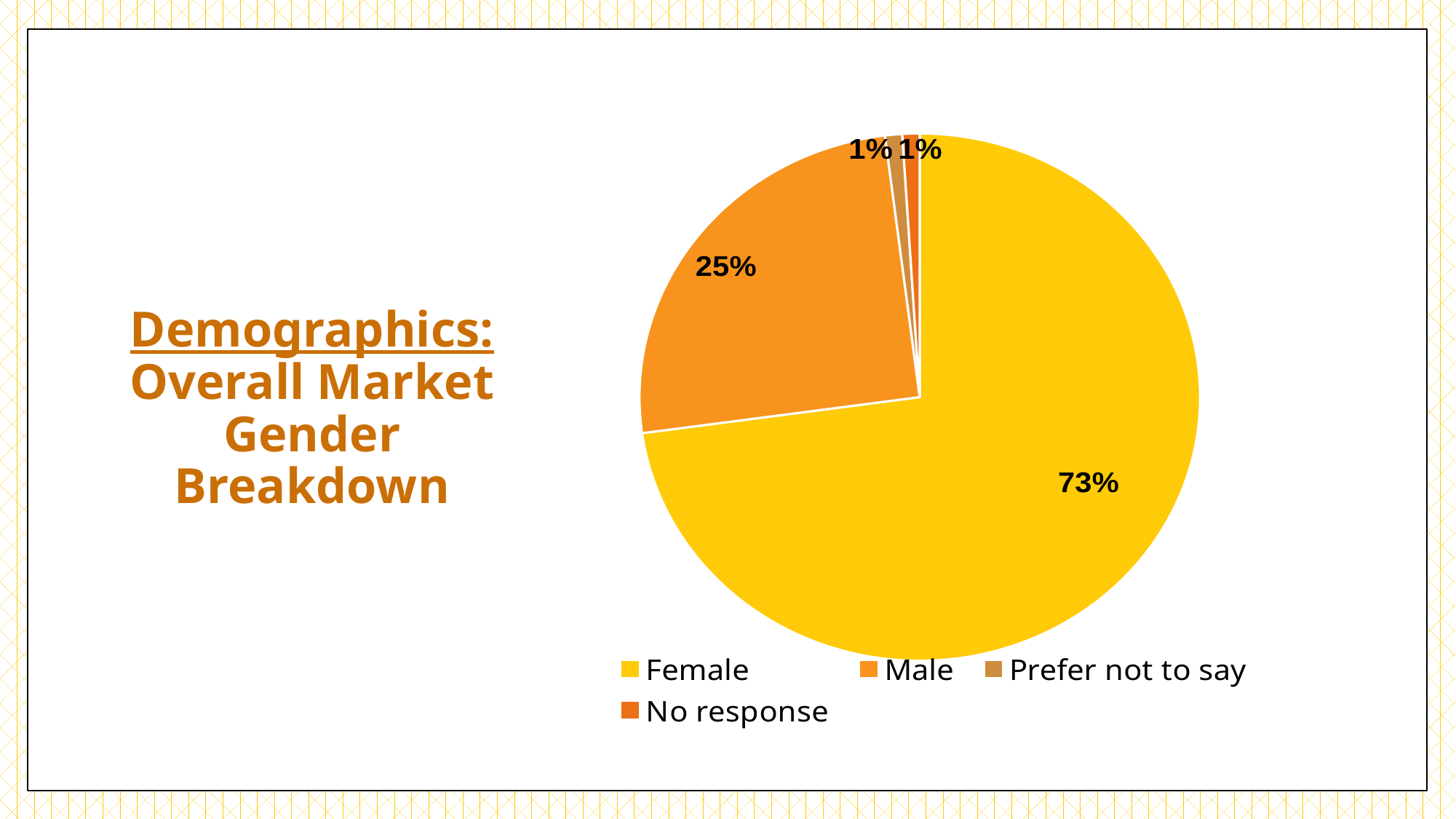
What kind of chart is shown on the slide? Pie chart What share of the pie is No response? 1% What colour is the Female slice? Yellow What is the difference in percentage points between the Female and Male slices? 48 How many categories does the legend list? 4 Which category has the largest slice of the pie? Female What is the title text shown to the left of the chart? Demographics: Overall Market Gender Breakdown Which is larger, the Female slice or the Male slice? Female What share of the pie is Female? 73% What share of the pie is Male? 25% What is the combined share of the Male and Female slices? 98%